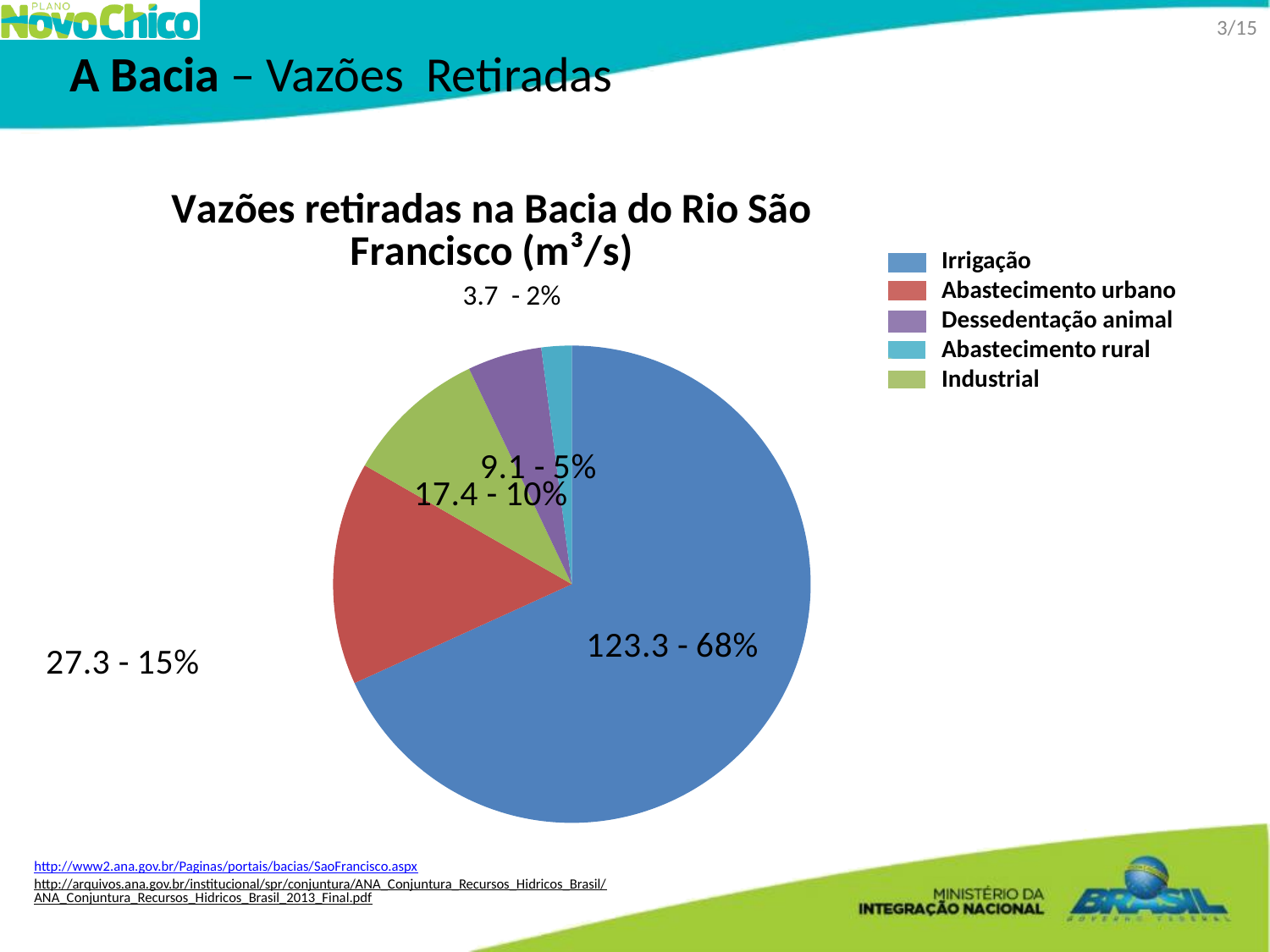
What is the value for Industrial? 17.4 How many slices does the pie chart have? 5 What is the title of the chart? Vazões retiradas na Bacia do Rio São Francisco (m³/s) What is the value for Abastecimento urbano? 27.3 Which category has the smallest slice of the pie? Abastecimento rural What kind of chart is shown on the slide? pie chart What is the value for Irrigação? 123.3 What is the value for Abastecimento rural? 3.7 What share of the pie does Dessedentação animal represent? 5% What is the difference between the values for Irrigação and Abastecimento urbano? 96.0 Which category has the largest slice of the pie? Irrigação How many categories does the legend list? 5